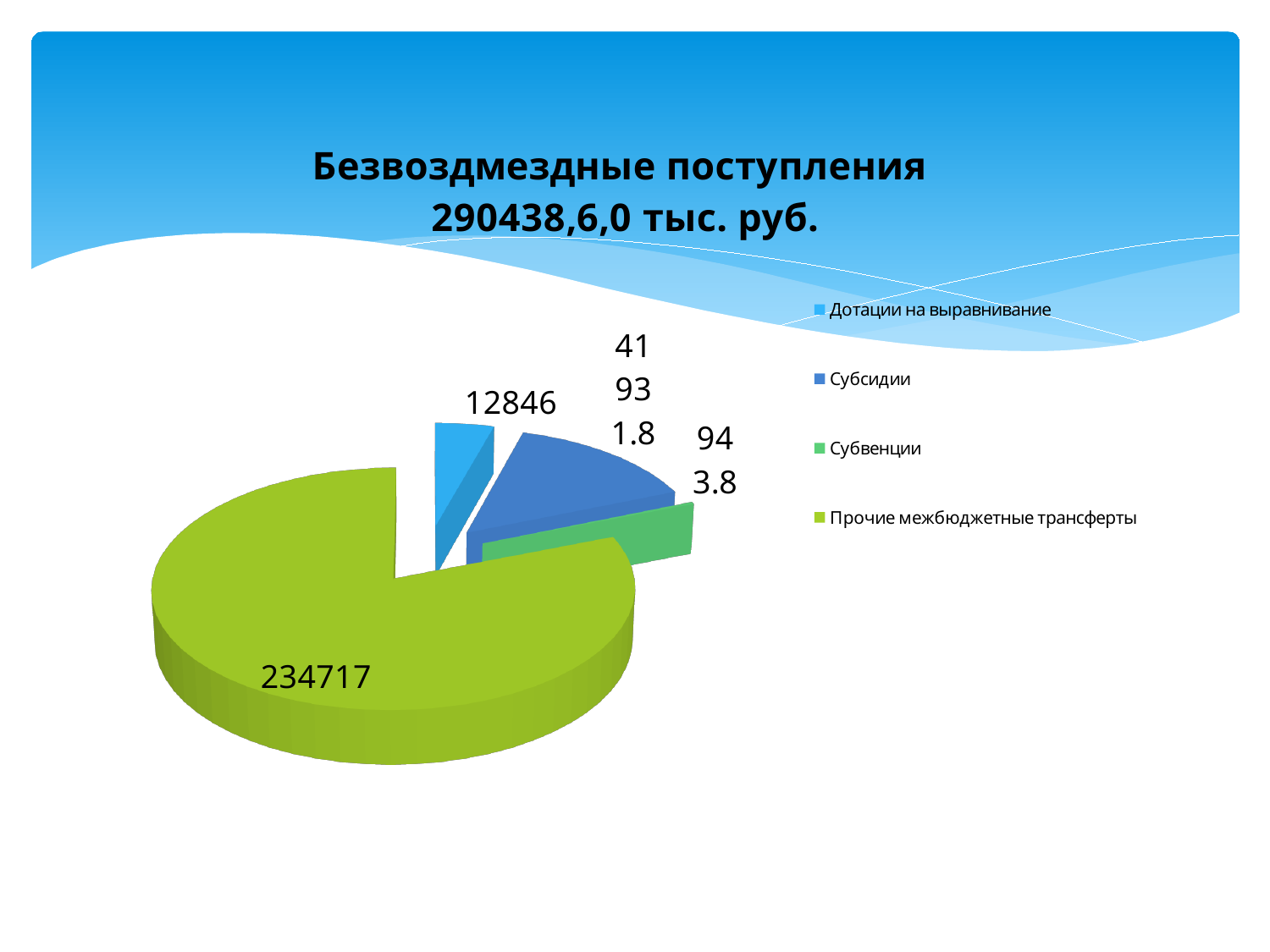
How many slices does the pie chart have? 4 Which category has the largest slice of the pie? Прочие межбюджетные трансферты What is the title of the chart? Безвоздмездные поступления 290438,6,0 тыс. руб. How many entries does the legend list? 4 What is the value for Субсидии? 41931.8 What is the value for Прочие межбюджетные трансферты? 234717 What kind of chart is shown on the slide? pie chart What is the difference between the value for Прочие межбюджетные трансферты and the value for Дотации на выравнивание? 221871 What colour is the slice for Прочие межбюджетные трансферты? green What is the value for Дотации на выравнивание? 12846 Which category has the smallest slice of the pie? Субвенции Which is larger, the value for Дотации на выравнивание or the value for Прочие межбюджетные трансферты? Прочие межбюджетные трансферты